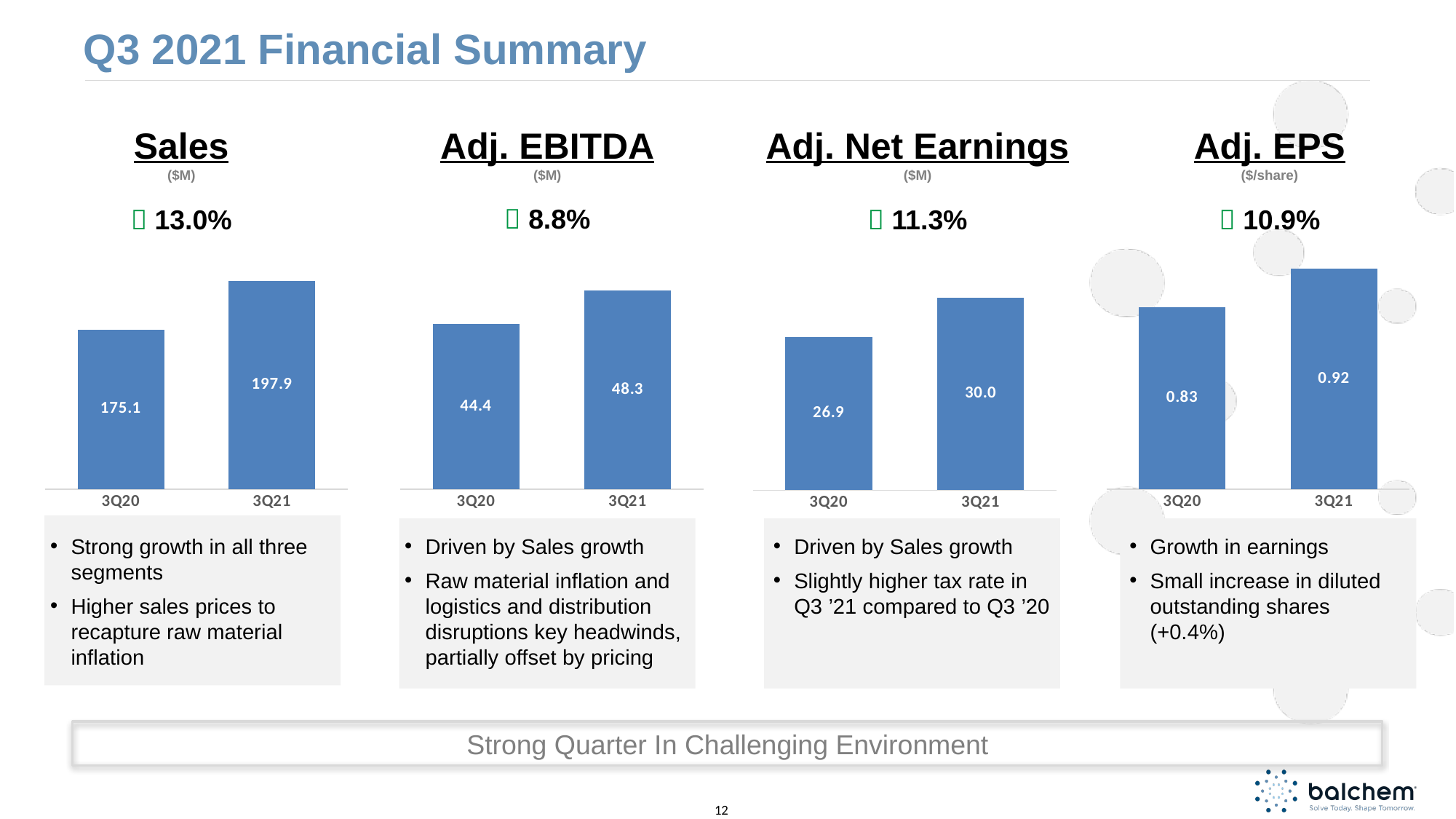
In the Sales chart, what is the value for 3Q21? 197.9 In the Sales chart, what is the difference between the 3Q21 and 3Q20 values? 22.8 In the Adj. Net Earnings chart, what is the value for 3Q21? 30.0 In the Adj. EPS chart, do the values rise or fall from 3Q20 to 3Q21? Rise In the Adj. EBITDA chart, what is the difference between the 3Q21 and 3Q20 values? 3.9 What kind of chart is the Adj. Net Earnings chart? Bar chart In the Adj. Net Earnings chart, which period has the higher value, 3Q20 or 3Q21? 3Q21 How many bars are shown in the Sales chart? 2 In the Adj. EPS chart, which period has the lowest value? 3Q20 In the Adj. EBITDA chart, what is the value for 3Q20? 44.4 In the Adj. EPS chart, what is the value for 3Q20? 0.83 What unit is shown under the Adj. EPS chart title? $/share